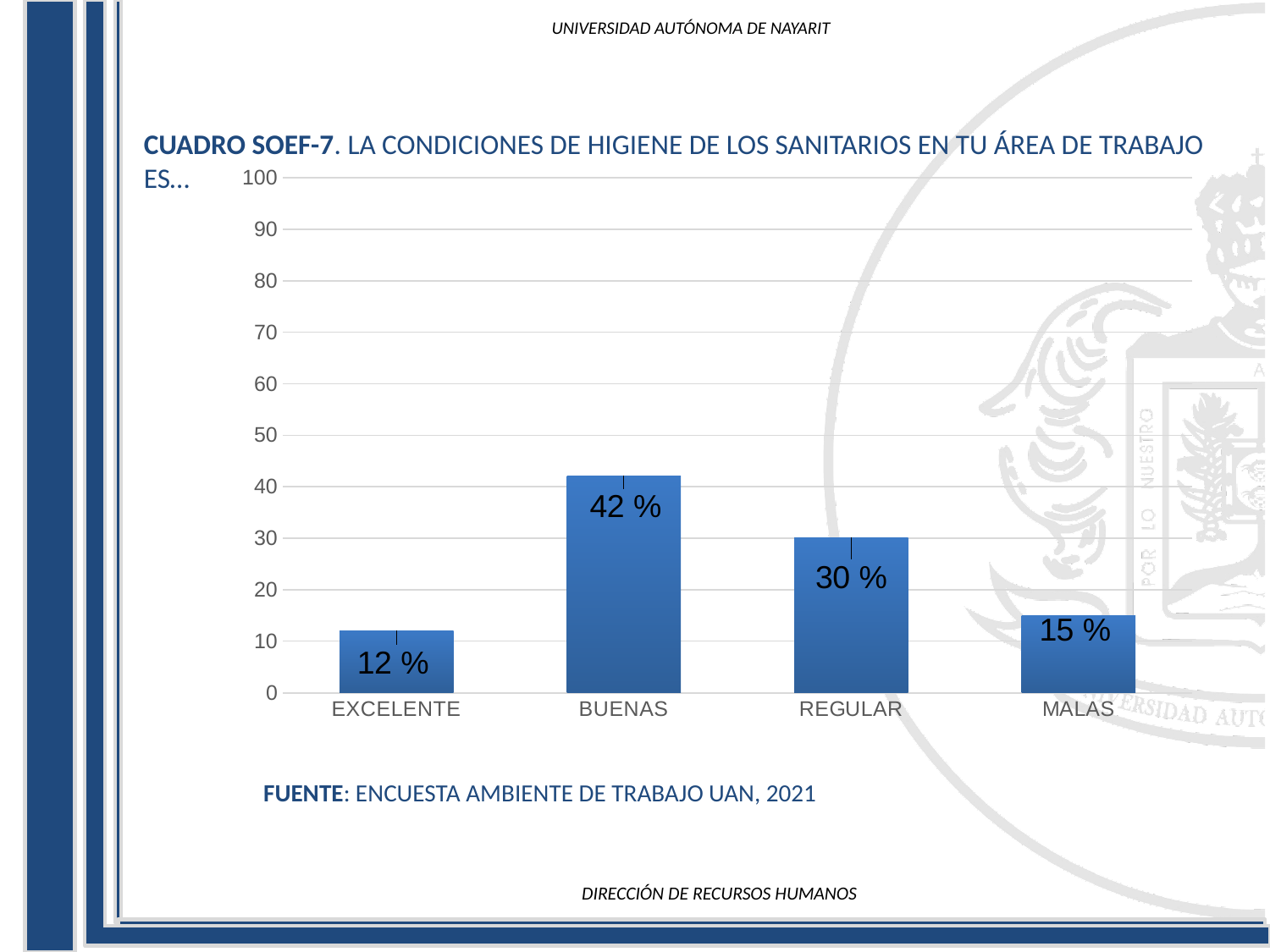
What is the value for BUENAS? 42 % What is the source cited below the chart? ENCUESTA AMBIENTE DE TRABAJO UAN, 2021 What kind of chart is shown on the slide? bar chart Which category has the lowest value? EXCELENTE Is the value for REGULAR greater or less than 50? less What is the value for MALAS? 15 % Which category has the highest value? BUENAS What is the difference between the values for REGULAR and MALAS? 15 % What is the difference between the values for BUENAS and REGULAR? 12 % What is the value for EXCELENTE? 12 % How many categories are shown on the x axis? 4 Which is larger, the value for MALAS or the value for EXCELENTE? MALAS